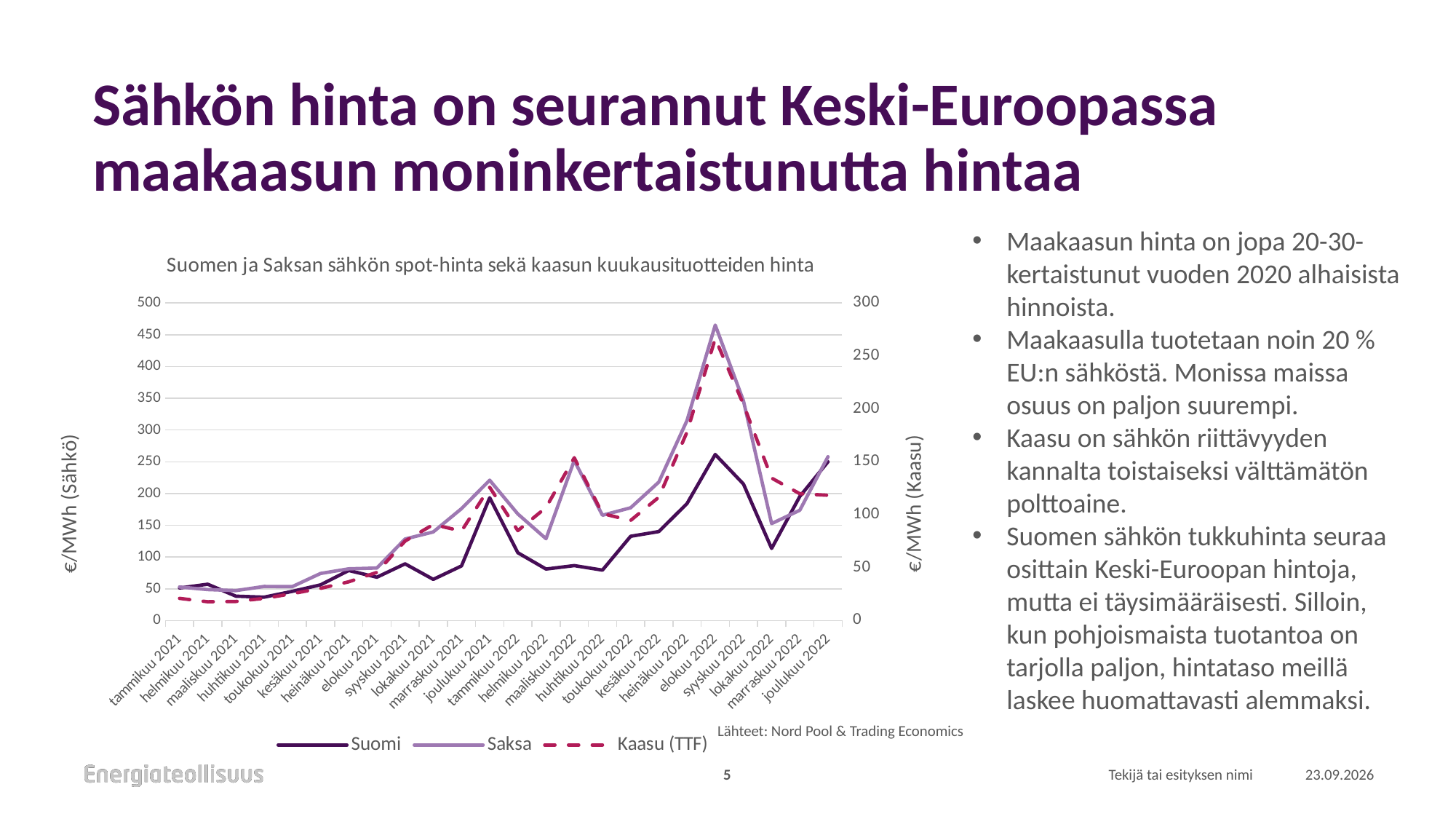
How many series does the chart legend list? 3 What is the title of the chart? Suomen ja Saksan sähkön spot-hinta sekä kaasun kuukausituotteiden hinta Is the value for Suomi in lokakuu 2022 greater or less than 150 on the left axis? less Is the value for Saksa in tammikuu 2021 greater or less than 100 on the left axis? less In which month does the Saksa series reach its highest value? elokuu 2022 Which series in the legend is drawn with a dashed line? Kaasu (TTF) Is the value for Saksa in elokuu 2022 greater or less than 400 on the left axis? greater How many monthly points are plotted along the x axis of the chart? 24 Does the Kaasu (TTF) series rise or fall between elokuu 2022 and joulukuu 2022? Fall What kind of chart is shown on the slide? Line chart In elokuu 2022, which series has the higher electricity price, Suomi or Saksa? Saksa